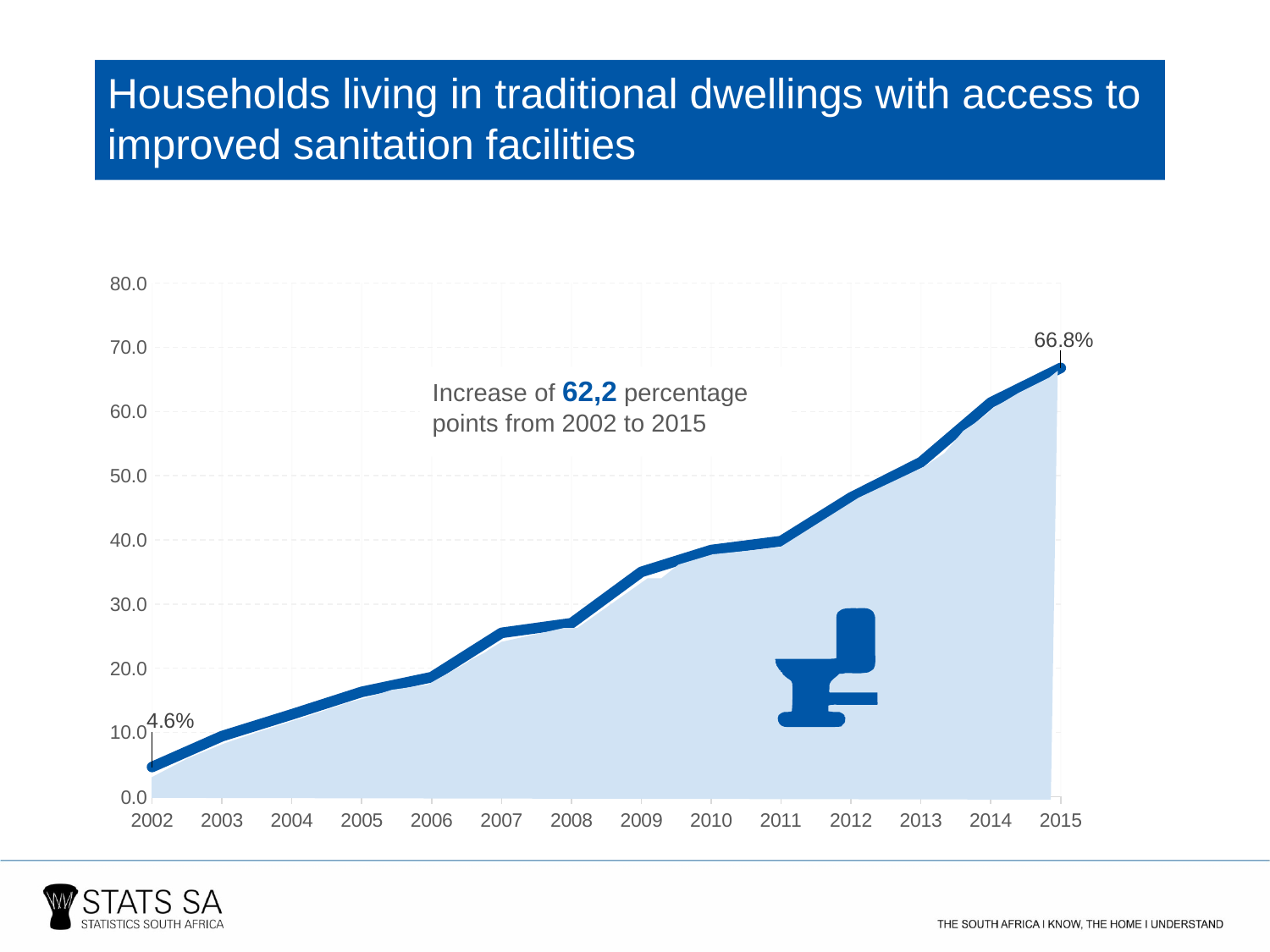
Do the values rise or fall from 2002 to 2015? Rise Is the value for 2013 greater or less than 60.0? less What is the difference between the values for 2015 and 2002, in percentage points? 62.2 Is the value for 2011 greater or less than 30.0? greater Which year has the highest value? 2015 Which is larger, the value for 2010 or the value for 2006? 2010 How many years are shown on the x axis? 14 What is the value for 2002? 4.6% What is the value for 2015? 66.8% What kind of chart is this? Area chart Which year has the lowest value? 2002 Is the value for 2005 greater or less than 20.0? less